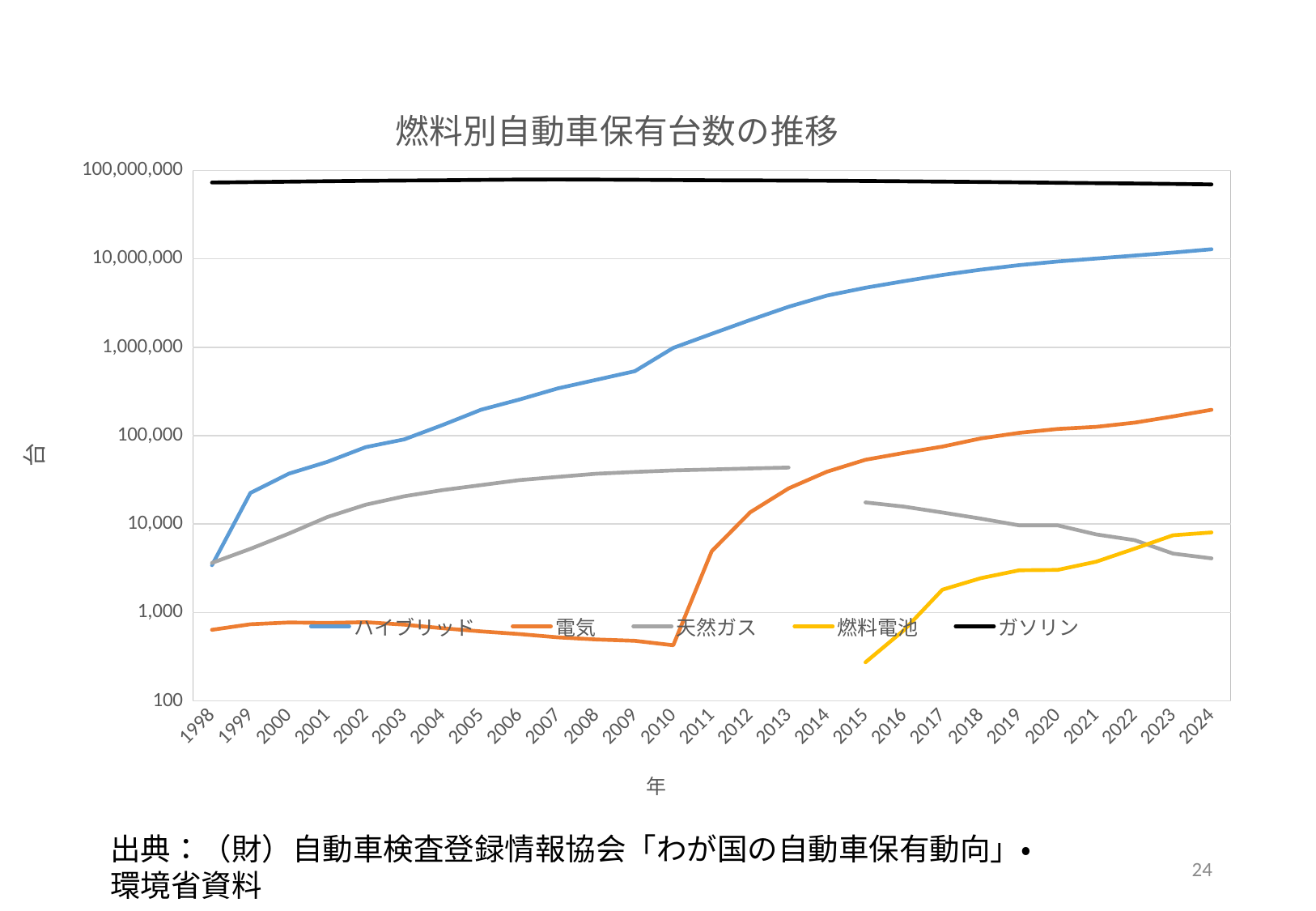
Which series has the highest value in 2024? ガソリン Is the value for 電気 in 2024 greater or less than 100,000? greater In 2024, which is larger: 燃料電池 or 天然ガス? 燃料電池 What is the title of the chart? 燃料別自動車保有台数の推移 Which series has the lowest value in 2015? 燃料電池 How many years are shown on the x axis? 27 Does the ハイブリッド series rise or fall from 1998 to 2024? rise What kind of chart is shown on the slide? line chart Is the value for 燃料電池 in 2024 greater or less than 10,000? less Is the value for ハイブリッド in 2024 greater or less than 10,000,000? greater How many series does the legend list? 5 Does the 天然ガス series rise or fall from 2015 to 2024? fall